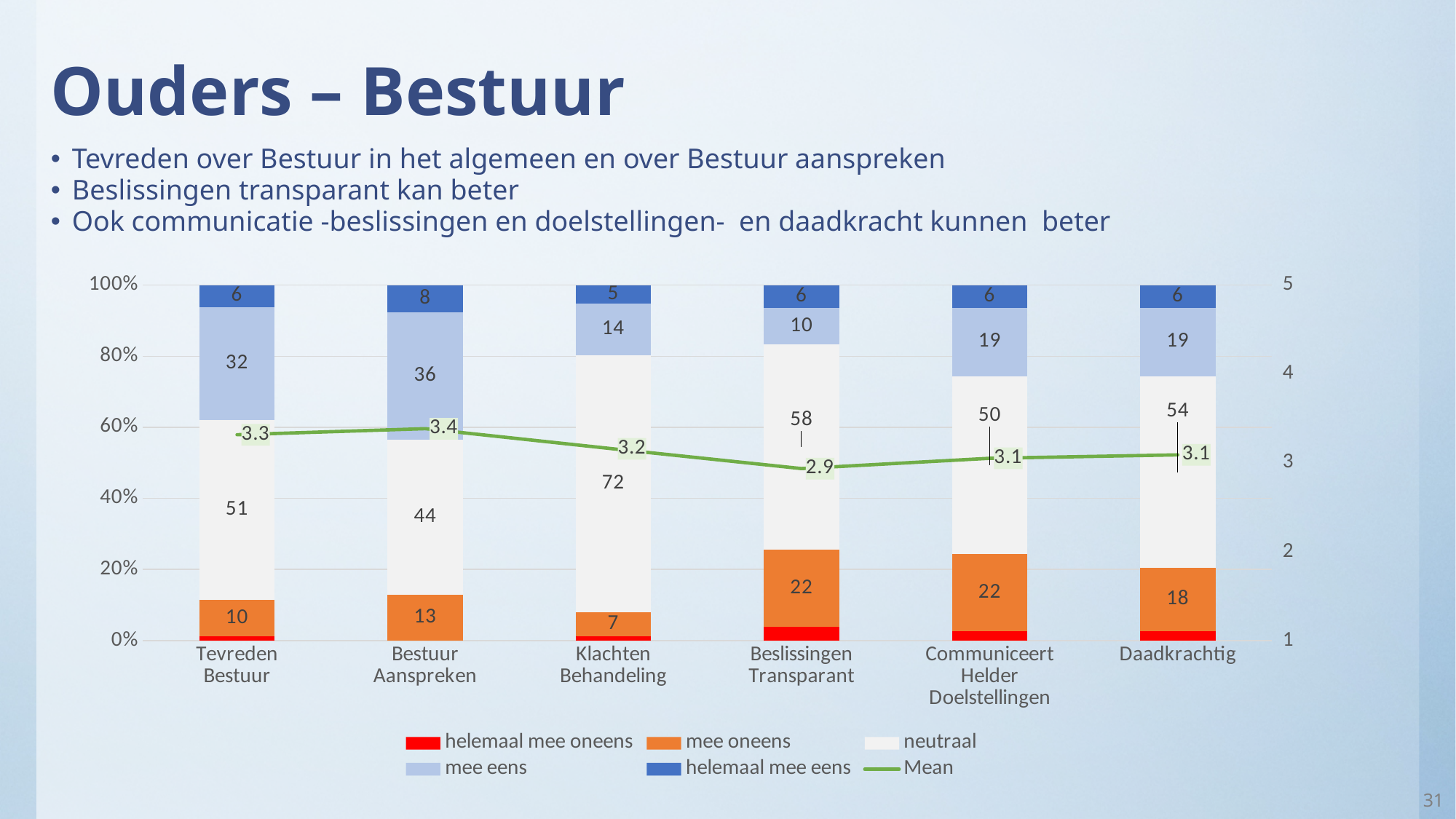
What is the 'helemaal mee eens' value for Bestuur Aanspreken? 8 What colour is the Mean line in the chart? Green Which category has the highest Mean value? Bestuur Aanspreken What kind of chart is shown on the slide? Stacked bar chart with a line What is the Mean value for Beslissingen Transparant? 2.9 Which category has the largest 'mee eens' segment? Bestuur Aanspreken Which category has the lowest Mean value? Beslissingen Transparant How many categories are shown on the x axis? 6 How many entries does the legend list? 6 Which has a larger 'mee oneens' value: Beslissingen Transparant or Daadkrachtig? Beslissingen Transparant What is the difference between the 'mee eens' values for Tevreden Bestuur and Klachten Behandeling? 18 What is the value of the 'neutraal' segment for Klachten Behandeling? 72